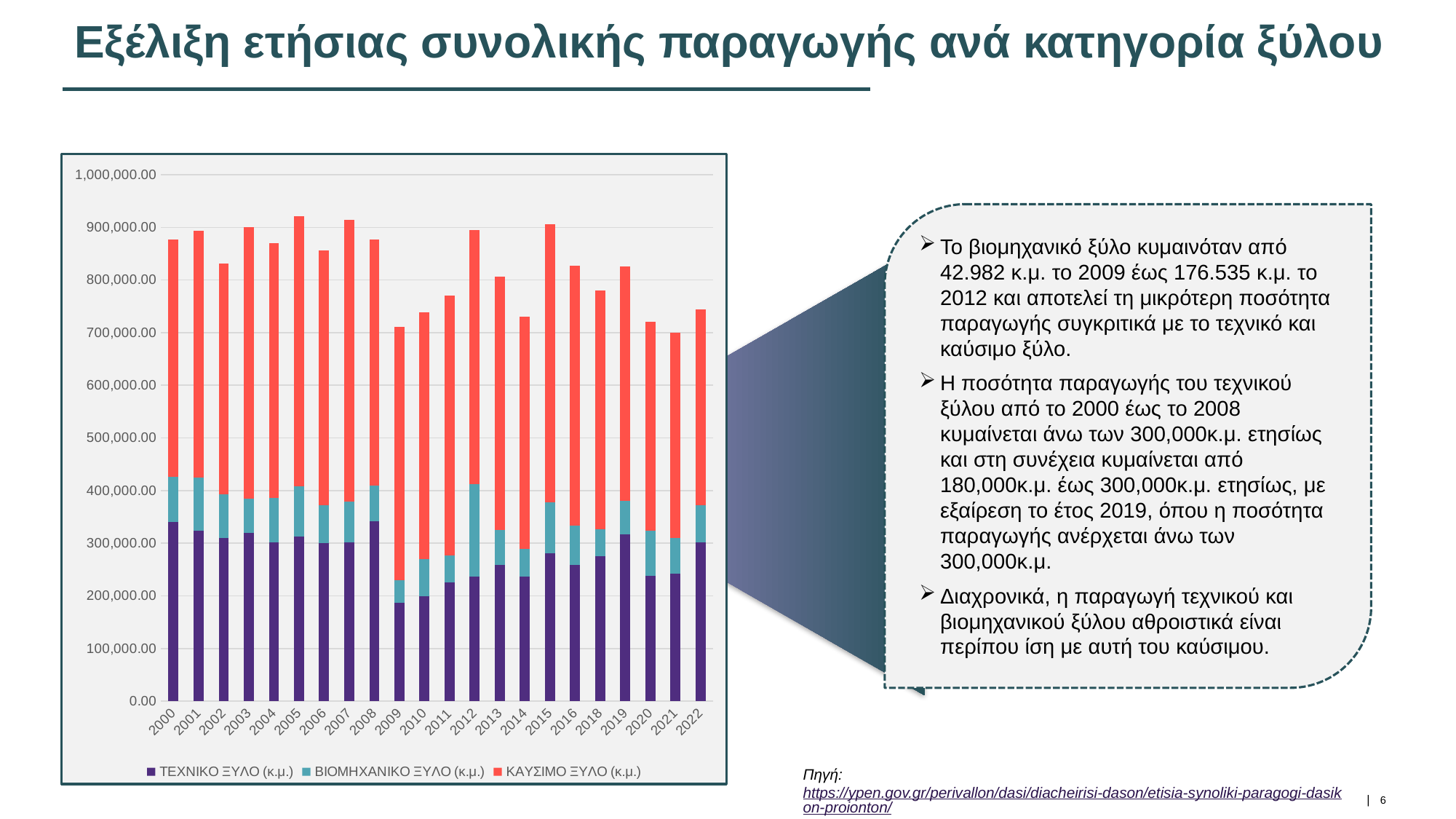
Which series is shown in red in the chart? ΚΑΥΣΙΜΟ ΞΥΛΟ (κ.μ.) What is the title of the slide containing the chart? Εξέλιξη ετήσιας συνολικής παραγωγής ανά κατηγορία ξύλου Is the value of ΤΕΧΝΙΚΟ ΞΥΛΟ (κ.μ.) for 2009 greater or less than 200,000.00? less Which year has the larger total stacked value, 2000 or 2009? 2000 Which year has the larger ΤΕΧΝΙΚΟ ΞΥΛΟ (κ.μ.) value, 2008 or 2010? 2008 Is the total stacked value for 2005 greater or less than 900,000.00? greater Does the total stacked value rise or fall from 2008 to 2009? fall What kind of chart is shown on the slide? Stacked bar chart How many years are shown on the x axis of the chart? 22 How many series does the chart legend list? 3 Is the value of ΤΕΧΝΙΚΟ ΞΥΛΟ (κ.μ.) for 2000 greater or less than 300,000.00? greater